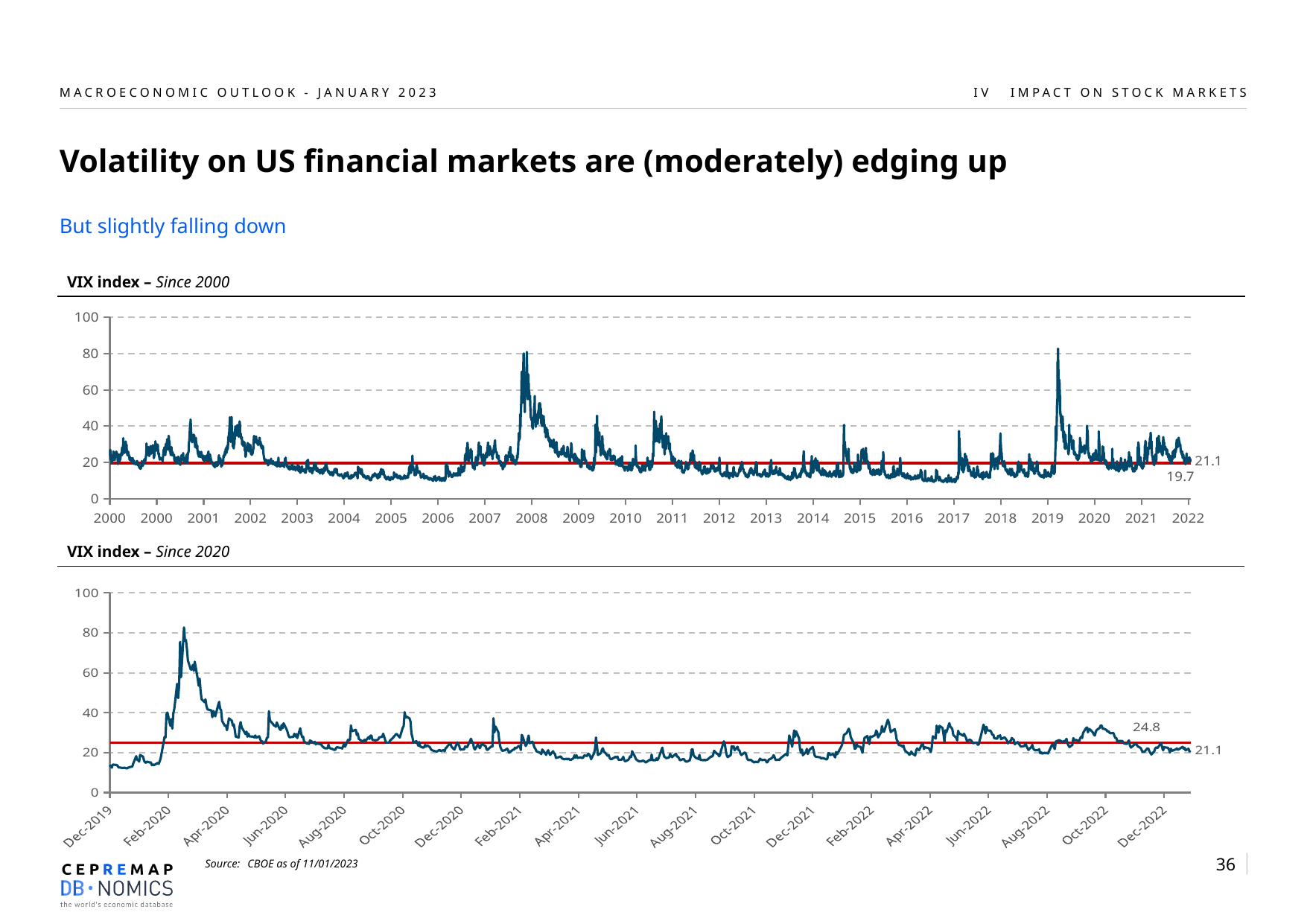
What kind of chart is the 'VIX index – Since 2000' chart? line chart In the 'VIX index – Since 2020' chart, what is the latest value of the VIX index labelled at the end of the line? 21.1 In the 'VIX index – Since 2000' chart, what value is labelled for the red horizontal line? 19.7 In the 'VIX index – Since 2000' chart, what is the latest value of the VIX index labelled at the end of the line? 21.1 In the 'VIX index – Since 2000' chart, is the latest VIX value greater or less than the red line value? greater In the 'VIX index – Since 2020' chart, is the peak of the VIX index around March 2020 greater or less than 60? greater In the 'VIX index – Since 2000' chart, is the peak of the VIX index in 2008 greater or less than 60? greater In the 'VIX index – Since 2000' chart, what is the difference between the latest VIX value and the red line value? 1.4 In the 'VIX index – Since 2020' chart, what is the difference between the red line value and the latest VIX value? 3.7 In the 'VIX index – Since 2020' chart, what value is labelled for the red horizontal line? 24.8 In the 'VIX index – Since 2020' chart, is the latest VIX value greater or less than the red line value? less What is the source cited for the charts on the slide? CBOE as of 11/01/2023